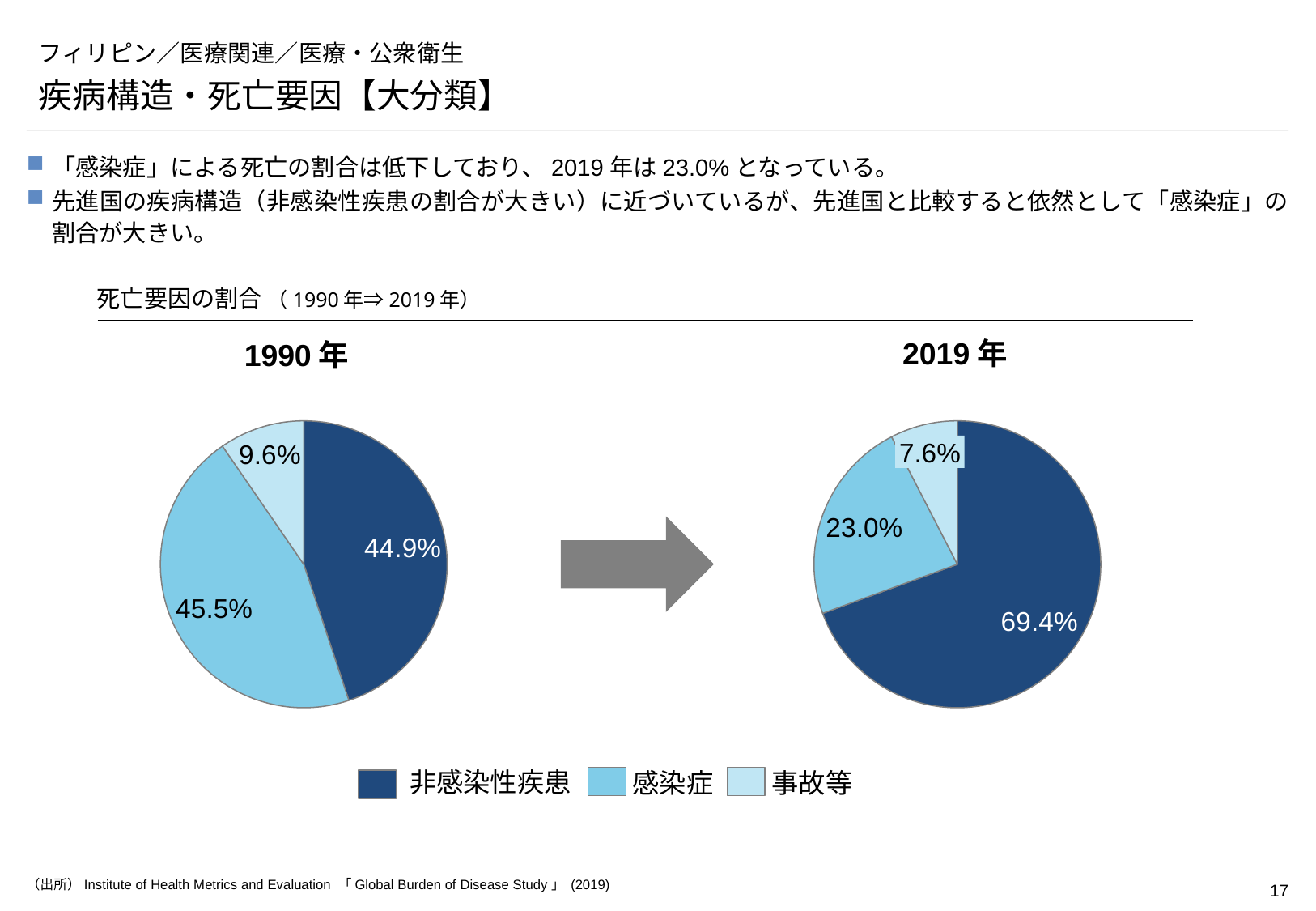
In the 1990年 pie chart, what share is shown for 感染症? 45.5% In the 2019年 pie chart, which category has the largest slice? 非感染性疾患 In the 2019年 pie chart, what share is shown for 事故等? 7.6% What is the difference between the 感染症 share in the 1990年 pie chart and in the 2019年 pie chart? 22.5% What type of chart is used to show the 死亡要因の割合 for each year? Pie chart In the 2019年 pie chart, what is the difference between the 非感染性疾患 share and the 感染症 share? 46.4% How many categories does the legend list for the pie charts? 3 In the 1990年 pie chart, which category has the smallest slice? 事故等 In the 2019年 pie chart, what share is shown for 非感染性疾患? 69.4% In the 2019年 pie chart, which category has the smallest slice? 事故等 In the 1990年 pie chart, what share is shown for 非感染性疾患? 44.9% Is the 事故等 share larger in the 1990年 pie chart or the 2019年 pie chart? 1990年